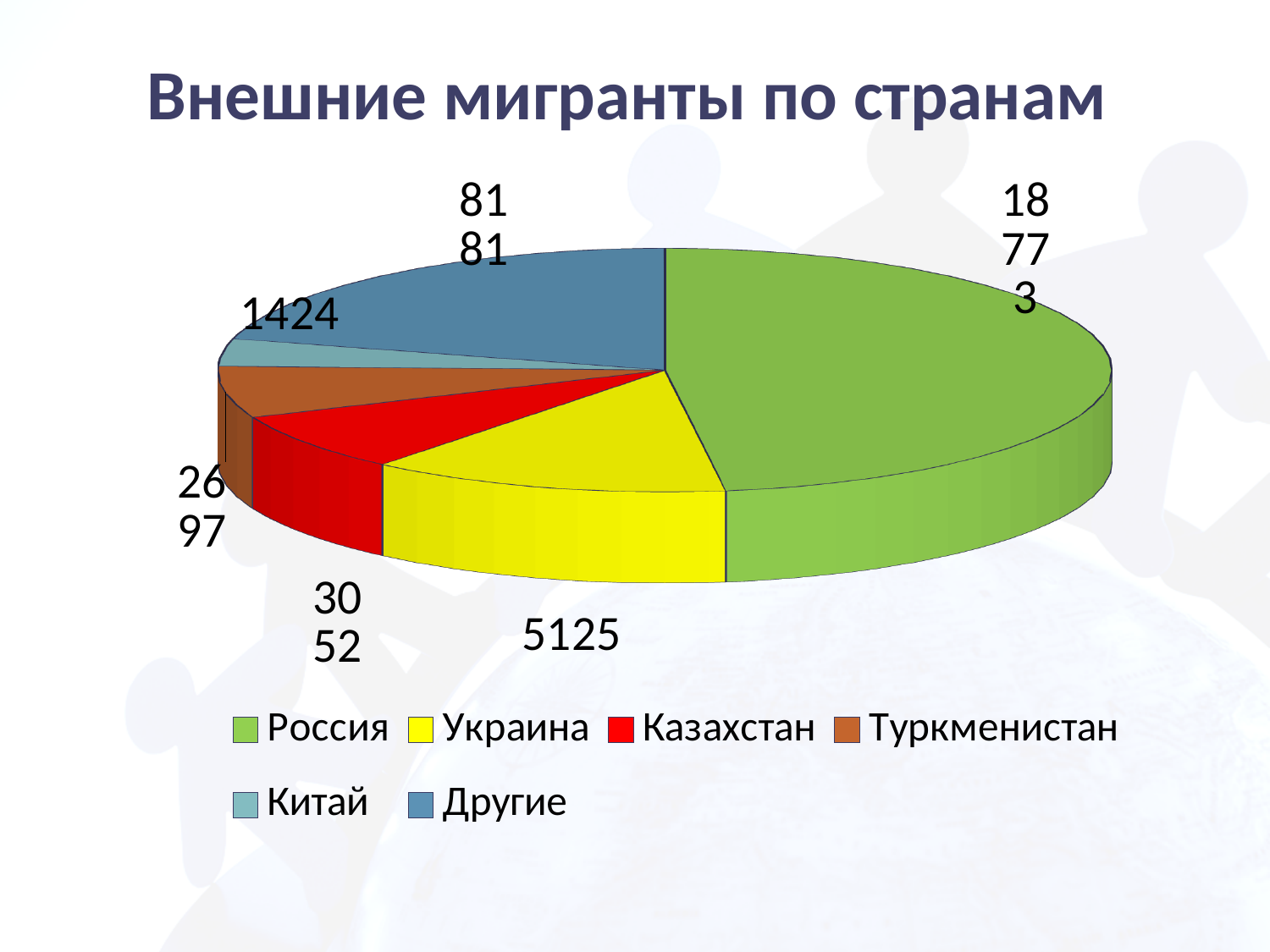
What is the value for Китай? 1424 Which category has the largest slice? Россия What is the value for Россия? 18773 Which category has the smallest slice? Китай How many categories (slices) does the pie chart have? 6 Which is larger, the value for Украина or the value for Казахстан? Украина What is the title of the chart? Внешние мигранты по странам What is the value for Другие? 8181 What colour is the slice for Казахстан? red What is the difference between the values for Украина and Китай? 3701 What is the value for Украина? 5125 What kind of chart is shown on the slide? pie chart